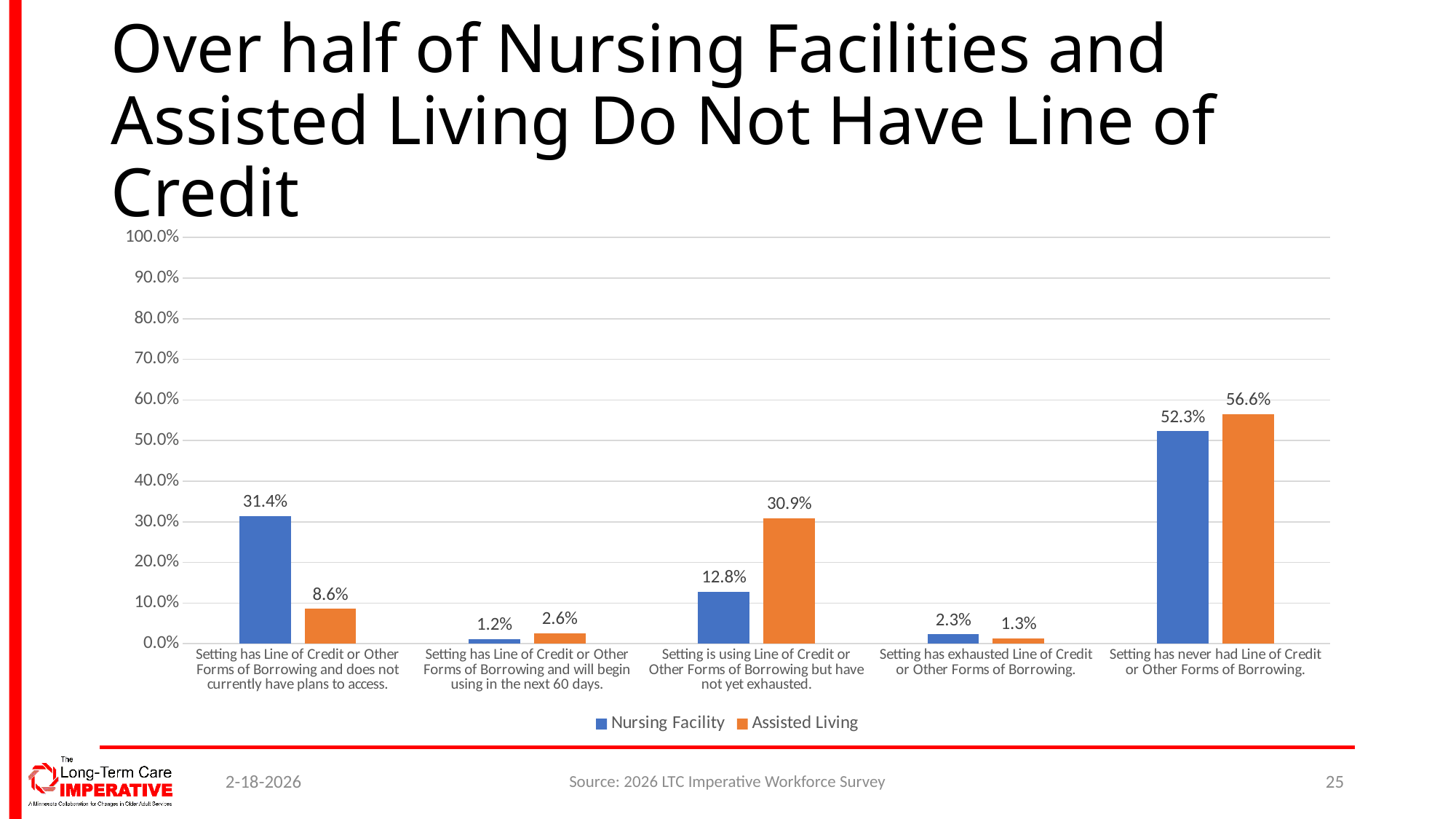
For "Setting has Line of Credit or Other Forms of Borrowing and does not currently have plans to access.", which series has the larger value, Nursing Facility or Assisted Living? Nursing Facility Which category has the highest Assisted Living value? Setting has never had Line of Credit or Other Forms of Borrowing. How many categories are shown on the x axis? 5 What kind of chart is shown on the slide? Bar chart What is the Assisted Living value for "Setting has Line of Credit or Other Forms of Borrowing and does not currently have plans to access."? 8.6% What is the difference between the Assisted Living and Nursing Facility values for "Setting has never had Line of Credit or Other Forms of Borrowing."? 4.3% Which category has the lowest Nursing Facility value? Setting has Line of Credit or Other Forms of Borrowing and will begin using in the next 60 days. Is the Nursing Facility value for "Setting has never had Line of Credit or Other Forms of Borrowing." greater or less than 50.0%? greater How many series does the legend list? 2 What is the Nursing Facility value for "Setting has never had Line of Credit or Other Forms of Borrowing."? 52.3% Which colour represents Assisted Living in the chart? Orange What is the Assisted Living value for "Setting is using Line of Credit or Other Forms of Borrowing but have not yet exhausted."? 30.9%